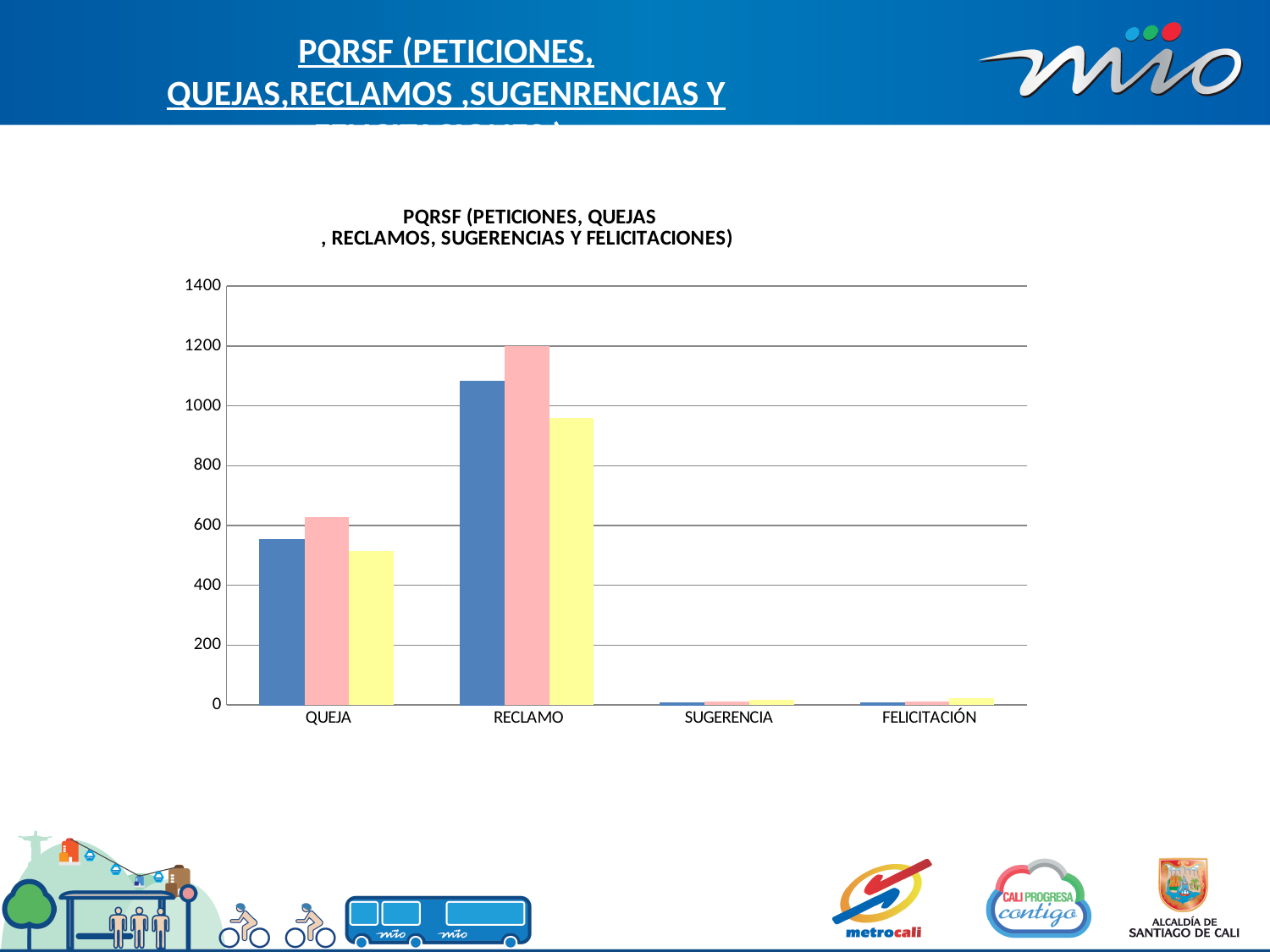
For QUEJA, which bar is taller, the blue bar or the pink bar? the pink bar What kind of chart is shown on the slide? bar chart Is the value of the yellow bar for QUEJA greater or less than 600? less Is the value of the yellow bar for RECLAMO greater or less than 1000? less Which category has the tallest bars in the chart? RECLAMO Is the value of the blue bar for QUEJA greater or less than 400? greater How many categories are shown on the x axis of the chart? 4 What is the highest value shown on the vertical axis of the chart? 1400 How many bars are plotted for each category in the chart? 3 Which category has the larger blue bar, QUEJA or RECLAMO? RECLAMO